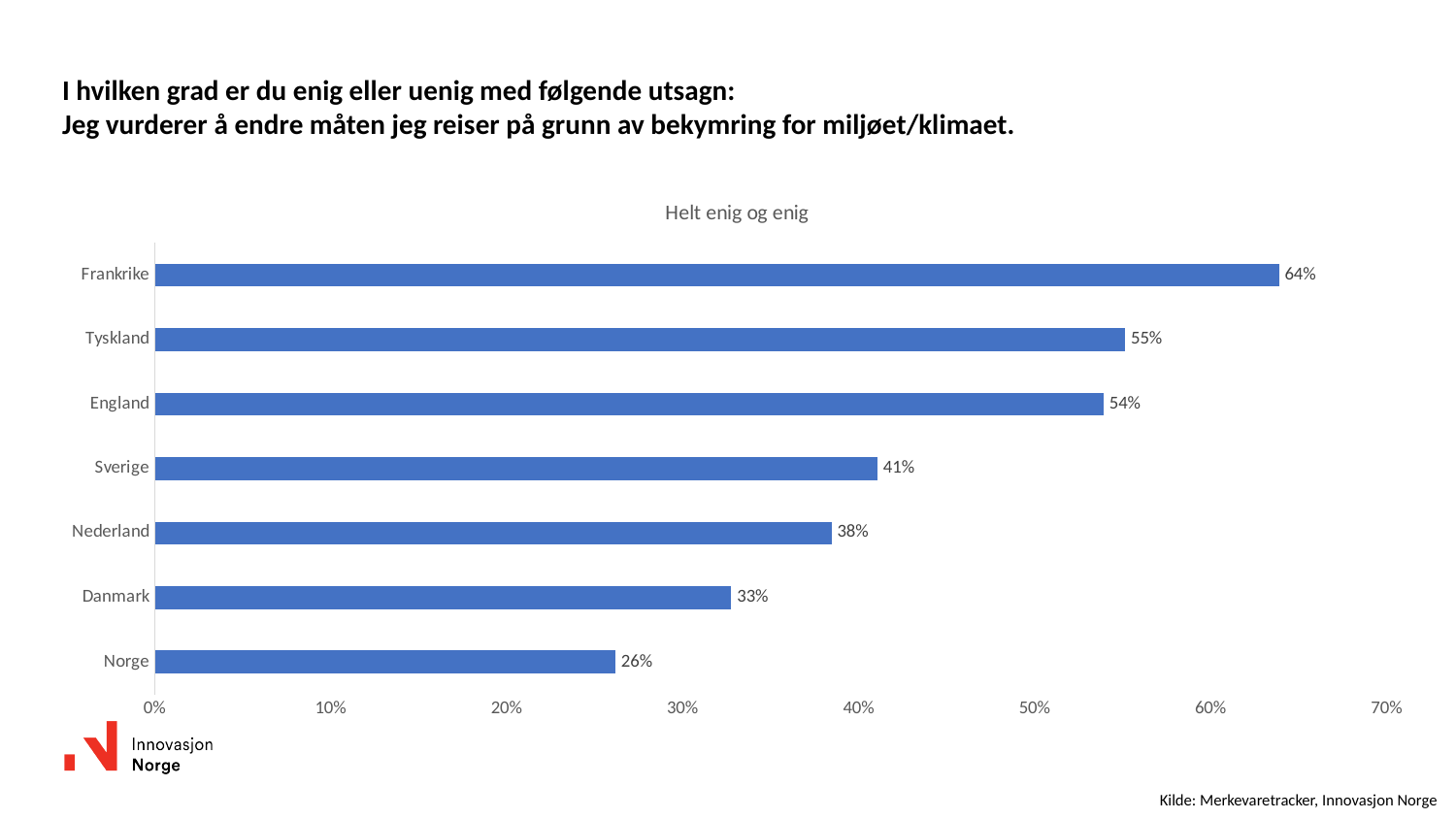
Which is larger, the value for Sverige or the value for Nederland? Sverige What kind of chart is shown on the slide? Bar chart What is the value for Frankrike? 64% What is the value for Norge? 26% What is the title of the chart? Helt enig og enig Which country has the lowest value? Norge What is the difference between the values for Sverige and Danmark? 8% What is the value for Nederland? 38% Which country has the highest value? Frankrike How many countries are shown in the chart? 7 Is the value for Tyskland greater or less than 50%? greater What is the difference between the values for Frankrike and Norge? 38%